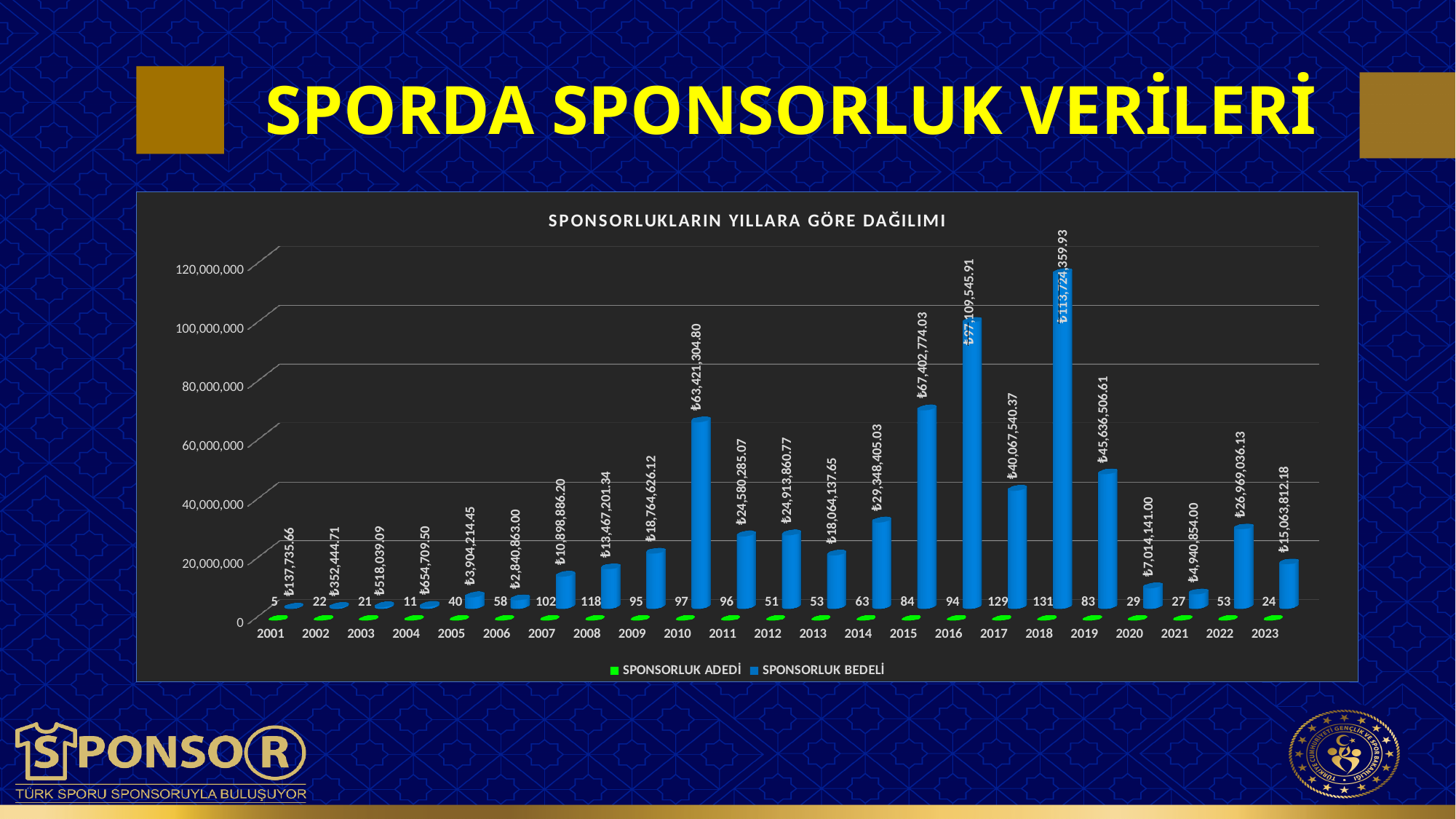
Which year has the larger SPONSORLUK BEDELİ, 2010 or 2015? 2015 Which year has the highest SPONSORLUK BEDELİ? 2018 What is the SPONSORLUK BEDELİ value for 2018? ₺113,724,359.93 What is the SPONSORLUK BEDELİ value for 2010? ₺63,421,304.80 Is the SPONSORLUK BEDELİ value for 2019 greater or less than 40,000,000? greater What is the difference in SPONSORLUK ADEDİ between 2018 and 2017? 2 What is the title of the chart? SPONSORLUKLARIN YILLARA GÖRE DAĞILIMI Which year has the lowest SPONSORLUK ADEDİ? 2001 How many series does the legend list? 2 What is the SPONSORLUK ADEDİ value for 2017? 129 How many years are shown on the x axis of the chart? 23 What type of chart is shown on the slide? bar chart